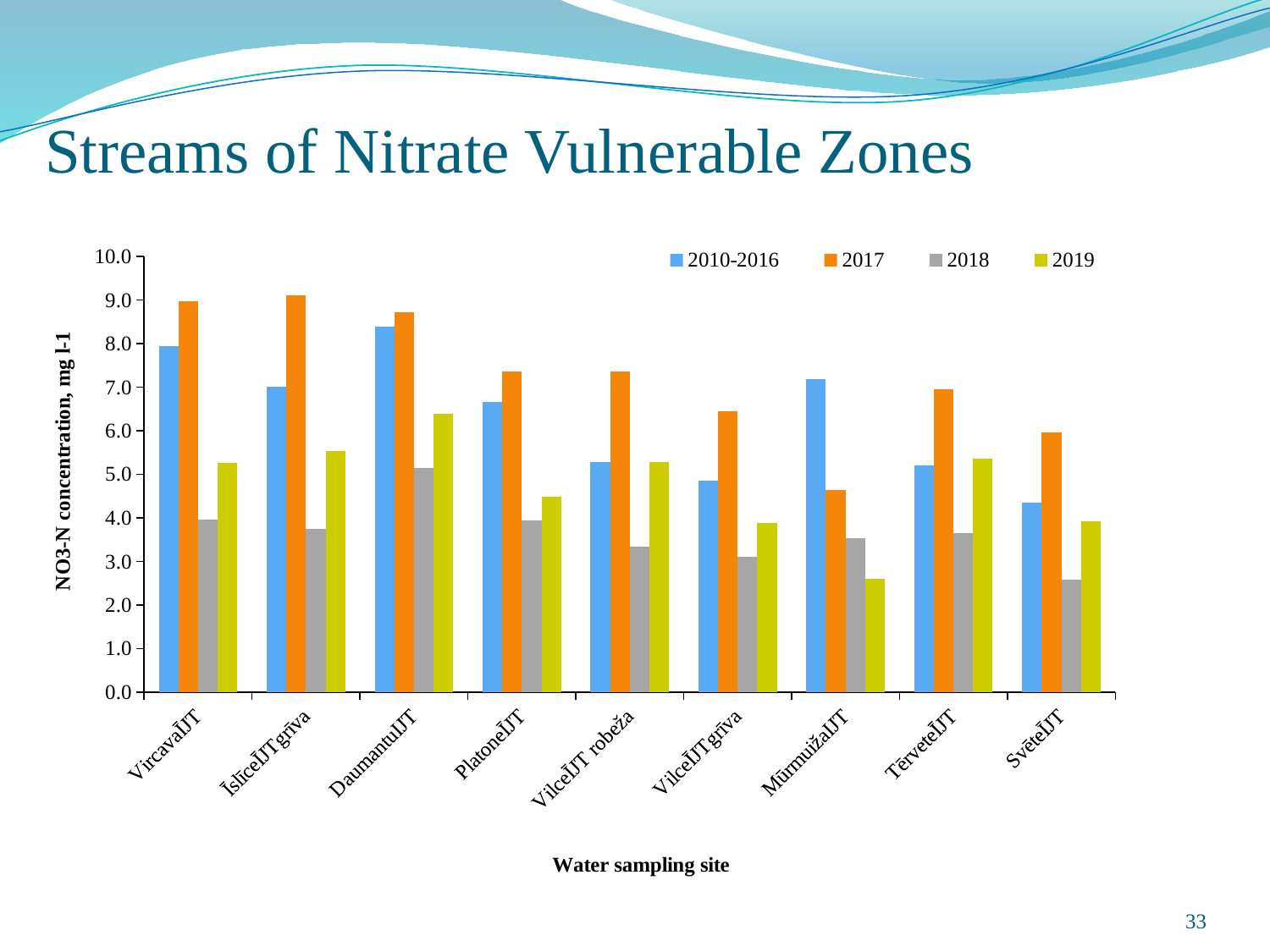
Is the 2019 value for MūrmuižaĪJT greater or less than 3.0? less Is the 2017 value for VircavaĪJT greater or less than 8.0? greater How many water sampling sites are shown on the x axis? 9 What is the title of the y axis? NO3-N concentration, mg l-1 What kind of chart is shown on the slide? bar chart How many series does the legend list? 4 For MūrmuižaĪJT, which is larger: the 2010-2016 value or the 2017 value? 2010-2016 Is the 2019 value for DaumantuĪJT greater or less than 6.0? greater Which water sampling site has the highest 2018 value? DaumantuIJT For SvēteĪJT, which is larger: the 2017 value or the 2018 value? 2017 Which water sampling site has the highest 2010-2016 value? DaumantuIJT Which water sampling site has the lowest 2019 value? MūrmuižaIJT